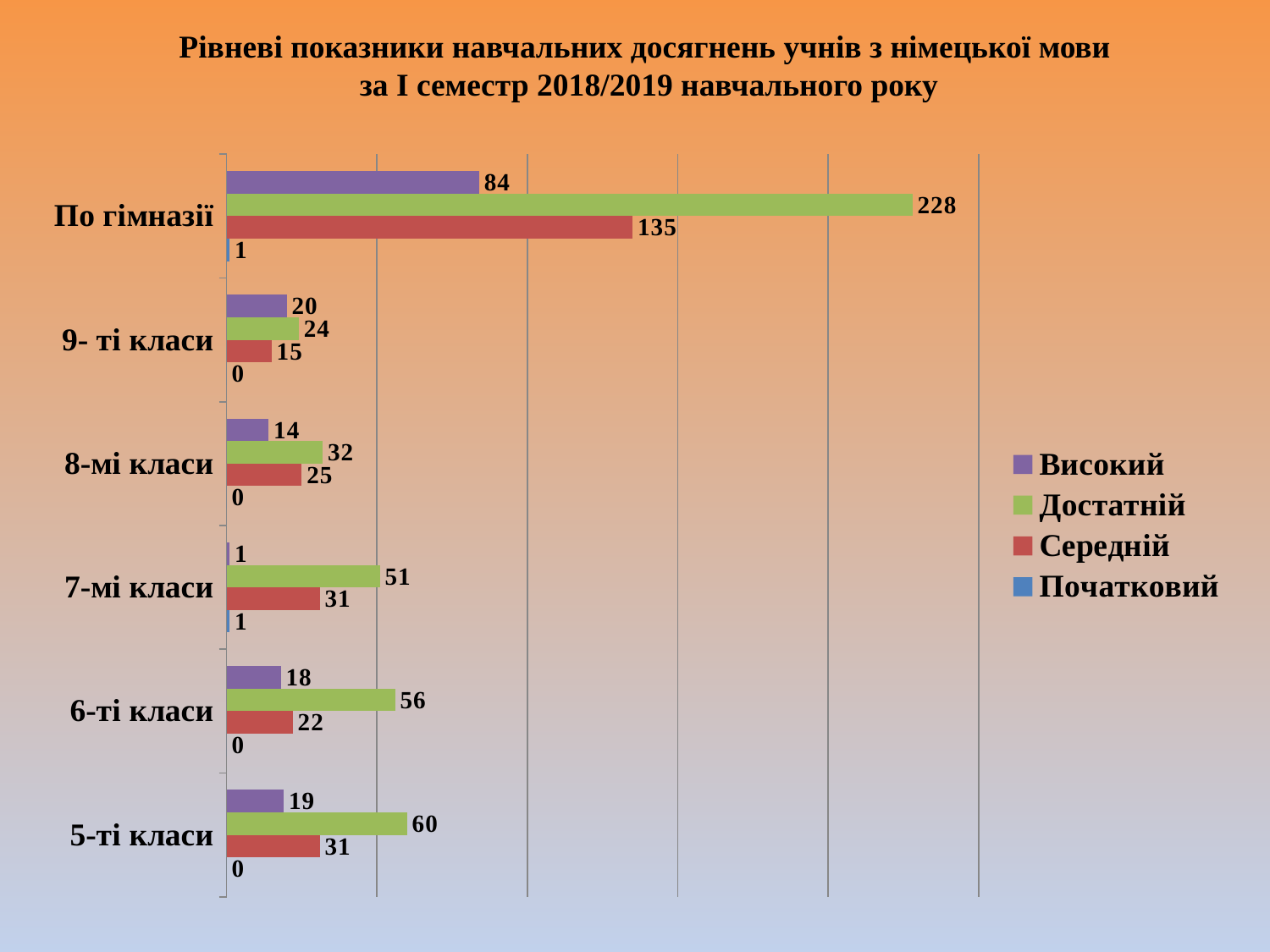
Which is larger for 8-мі класи: the Достатній value or the Середній value? Достатній Among the class groups (excluding По гімназії), which category has the highest Достатній value? 5-ті класи What is the difference between the Достатній and Середній values for По гімназії? 93 What is the value for Середній for 7-мі класи? 31 What kind of chart is shown on the slide? Bar chart Which series is shown in green in the legend? Достатній What is the value for Достатній for По гімназії? 228 How many series does the legend list? 4 Among the class groups (excluding По гімназії), which category has the lowest Високий value? 7-мі класи What is the value for Початковий for 7-мі класи? 1 What is the value for Високий for 5-ті класи? 19 How many categories are shown on the vertical axis? 6